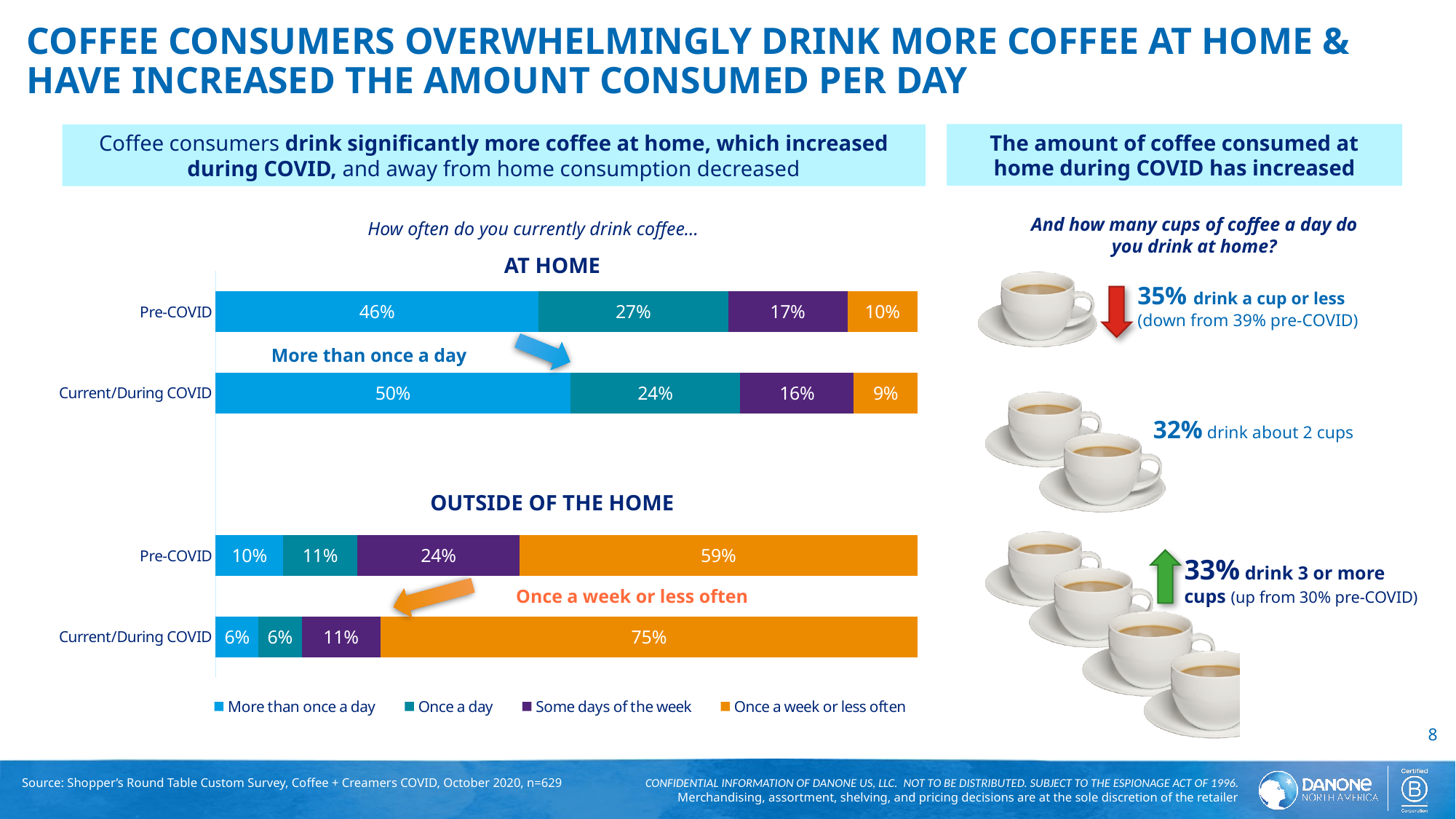
In the OUTSIDE OF THE HOME chart, which segment is largest in the Current/During COVID bar? Once a week or less often In the OUTSIDE OF THE HOME chart, what is the Current/During COVID value for 'Once a week or less often'? 75% In the AT HOME chart, by how many percentage points did 'More than once a day' change from Pre-COVID to Current/During COVID? 4 percentage points In the AT HOME chart, what percentage of Pre-COVID consumers drink coffee more than once a day? 46% In the AT HOME chart, what is the Current/During COVID value for 'Once a day'? 24% In the OUTSIDE OF THE HOME chart, what is the difference between the Current/During COVID and Pre-COVID values for 'Once a week or less often'? 16 percentage points In the AT HOME chart, is the Pre-COVID 'Once a day' value larger or smaller than the Current/During COVID 'Once a day' value? larger What type of chart is used for the AT HOME and OUTSIDE OF THE HOME data? Stacked bar chart How many series does the legend list for the stacked bar charts? 4 In the AT HOME chart, which segment is smallest in the Pre-COVID bar? Once a week or less often In the OUTSIDE OF THE HOME chart, what is the Pre-COVID value for 'Some days of the week'? 24% What colour represents 'Once a week or less often' in the legend? Orange